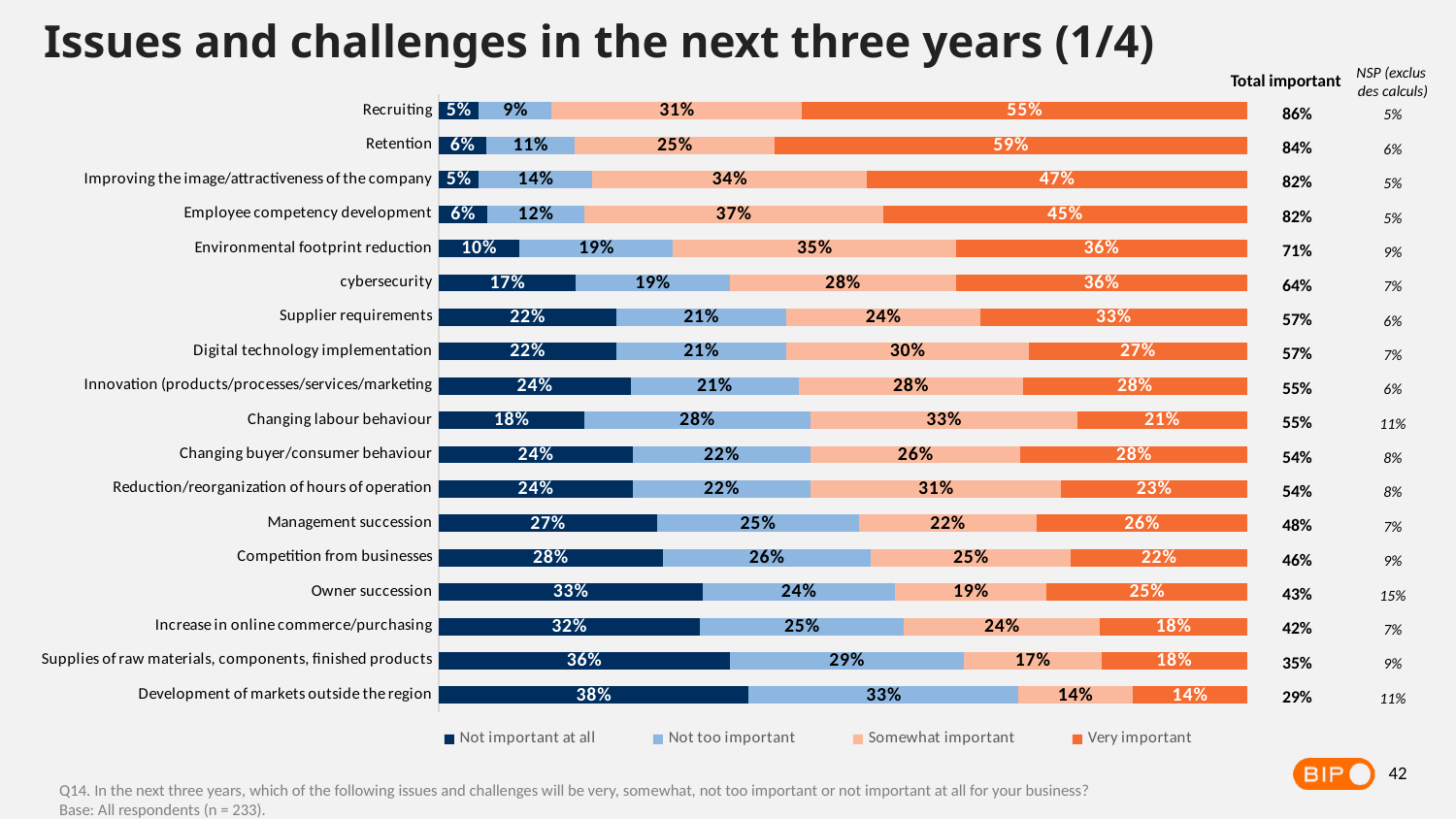
What percentage of respondents rated Recruiting as "Very important"? 55% Which issue has the lowest "Very important" percentage? Development of markets outside the region Which issue has the highest "Very important" percentage? Retention How many series does the legend list? 4 What is the combined percentage of "Not important at all" and "Not too important" for Owner succession? 57% Which has a larger "Somewhat important" value: Employee competency development or Improving the image/attractiveness of the company? Employee competency development Which legend entry is shown in dark orange? Very important What is the difference in percentage points between the "Very important" values for Retention and Recruiting? 4 percentage points What is the "Not important at all" value for Development of markets outside the region? 38% How many issues/challenges are listed in the chart? 18 What is the "Total important" value shown for cybersecurity? 64% What type of chart is shown on the slide? Stacked horizontal bar chart